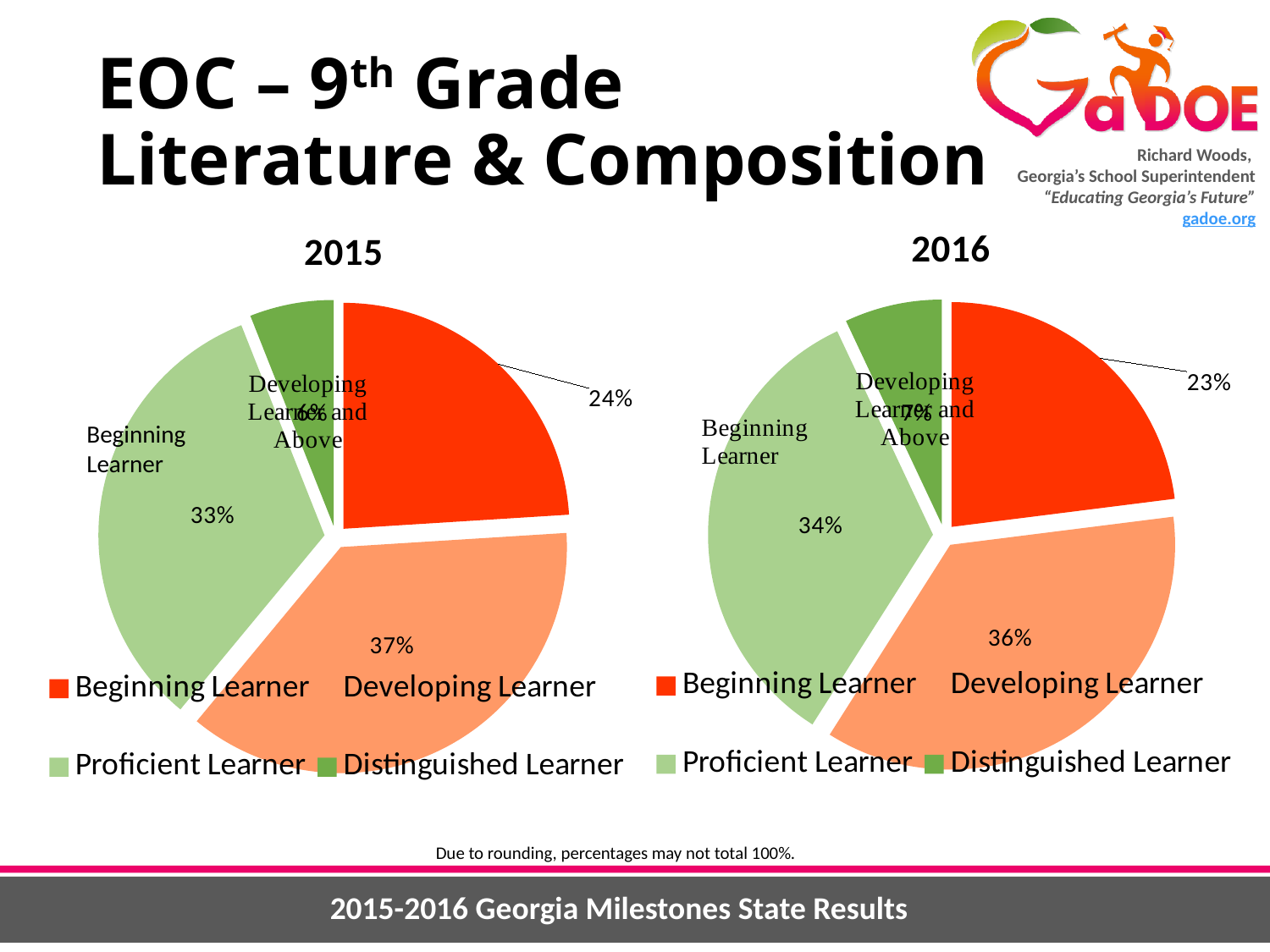
In the 2015 pie chart, what percentage is shown for Developing Learner? 37% In the 2016 pie chart, which category has the smallest share? Distinguished Learner In the 2016 pie chart, what is the combined share of Beginning Learner and Developing Learner? 59% How many categories does the 2016 pie chart show? 4 In the 2015 pie chart, which category has the largest share? Developing Learner In the 2015 pie chart legend, which colour represents Proficient Learner? Light green In the 2016 pie chart, what percentage is shown for Proficient Learner? 34% In the 2015 pie chart, what percentage is shown for Proficient Learner? 33% Which is larger: the Beginning Learner share in 2015 or in 2016? 2015 What type of chart is used for the 2015 results? Pie chart In the 2016 pie chart, what percentage is shown for Beginning Learner? 23% What is the difference between the Developing Learner share in 2015 and in 2016? 1%